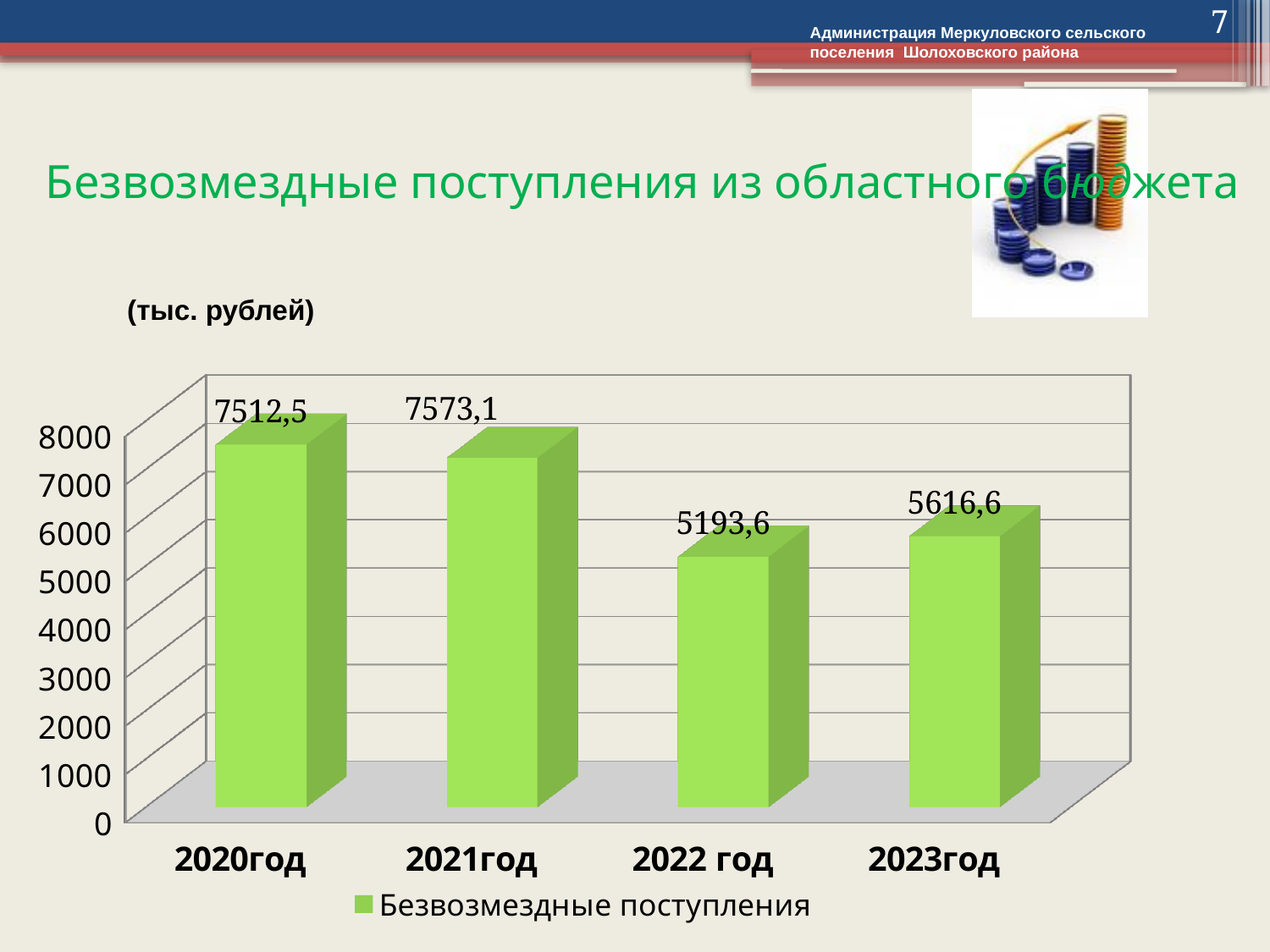
What is the value for 2022 год? 5193,6 Which is larger, the value for 2020год or the value for 2023год? 2020год What is the difference between the values for 2023год and 2022 год? 423 What kind of chart is shown on the slide? bar chart What is the value for 2020год? 7512,5 Which year has the lowest value? 2022 год Is the value for 2022 год greater or less than 5000? greater How many years are shown on the chart? 4 What series name does the legend show? Безвозмездные поступления What is the value for 2023год? 5616,6